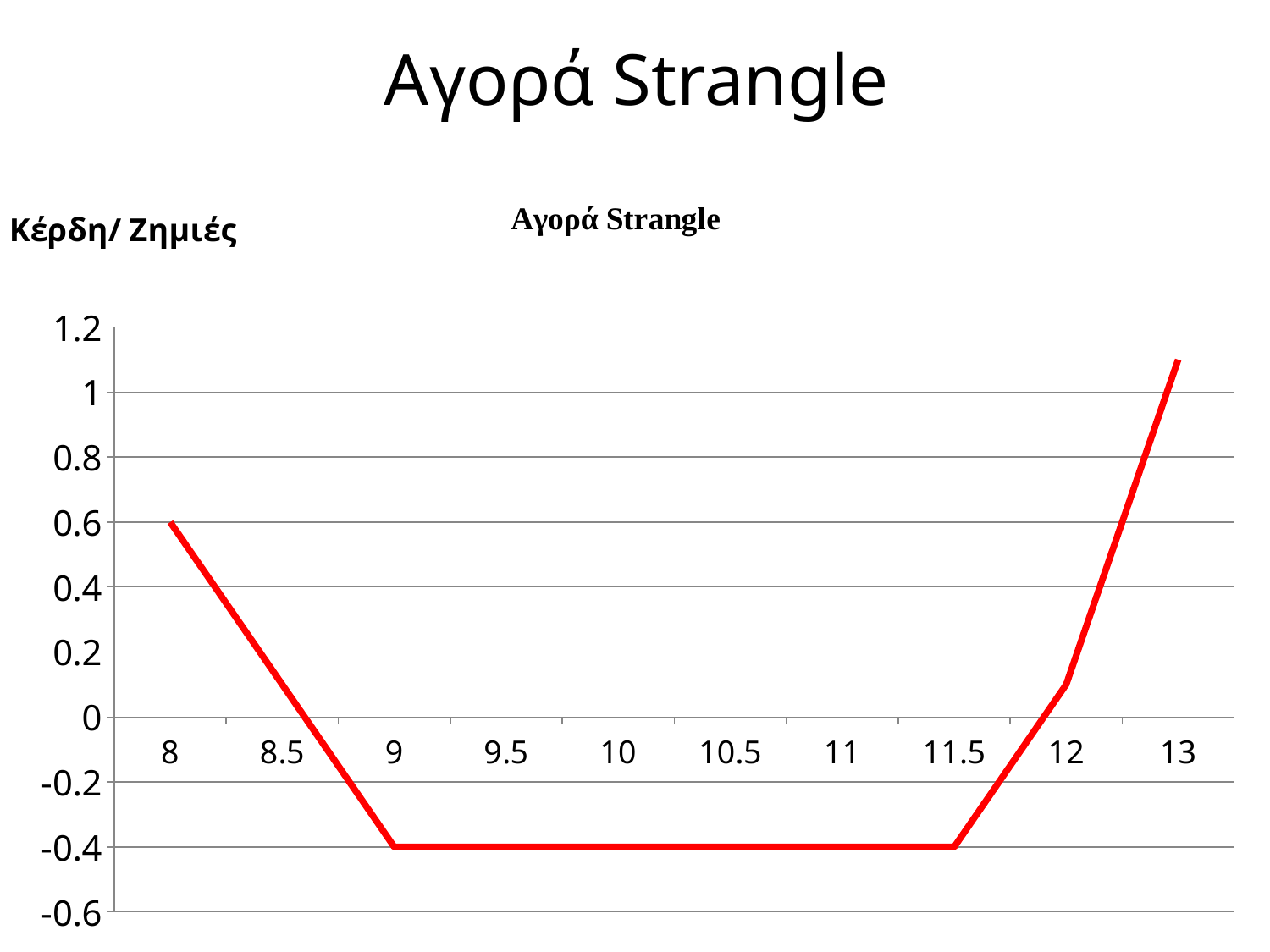
At which x value does the line reach its highest point? 13 What is the difference between the value at x = 8 and the value at x = 10? 1 What kind of chart is shown on the slide? line chart Is the value at x = 12 greater or less than 0.2? less What is the title of the chart? Αγορά Strangle Does the line rise or fall between x = 11.5 and x = 13? rise Is the value at x = 13 greater or less than 1? greater What is the value of the line at x = 10? -0.4 What is the value of the line at x = 8? 0.6 What is the value of the line at x = 11.5? -0.4 Which has the higher value, x = 8 or x = 12? 8 How many x-axis categories are shown on the chart? 10